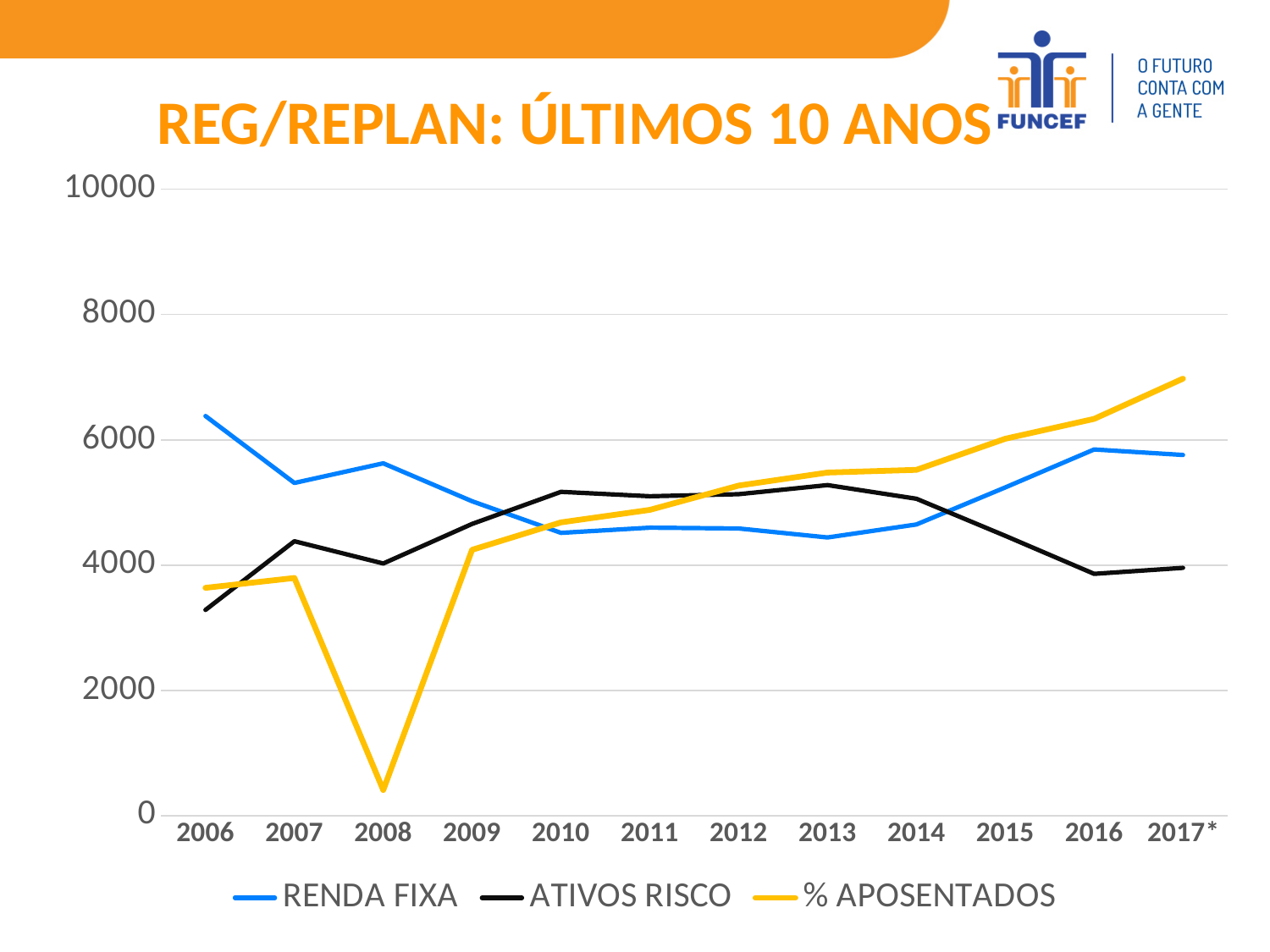
In which year is the RENDA FIXA series at its highest? 2006 In which year is the % APOSENTADOS series at its lowest? 2008 How many series does the legend list? 3 In 2017*, which series is higher: % APOSENTADOS or ATIVOS RISCO? % APOSENTADOS In which year is the % APOSENTADOS series at its highest? 2017* Is the value for RENDA FIXA in 2006 greater or less than 6000? greater Is the value for ATIVOS RISCO in 2006 greater or less than 4000? less What kind of chart is shown on the slide? line chart How many years are shown on the x axis? 12 Is the value for % APOSENTADOS in 2008 greater or less than 2000? less What is the title of the chart? REG/REPLAN: ÚLTIMOS 10 ANOS Does the % APOSENTADOS series rise or fall from 2009 to 2017*? rise